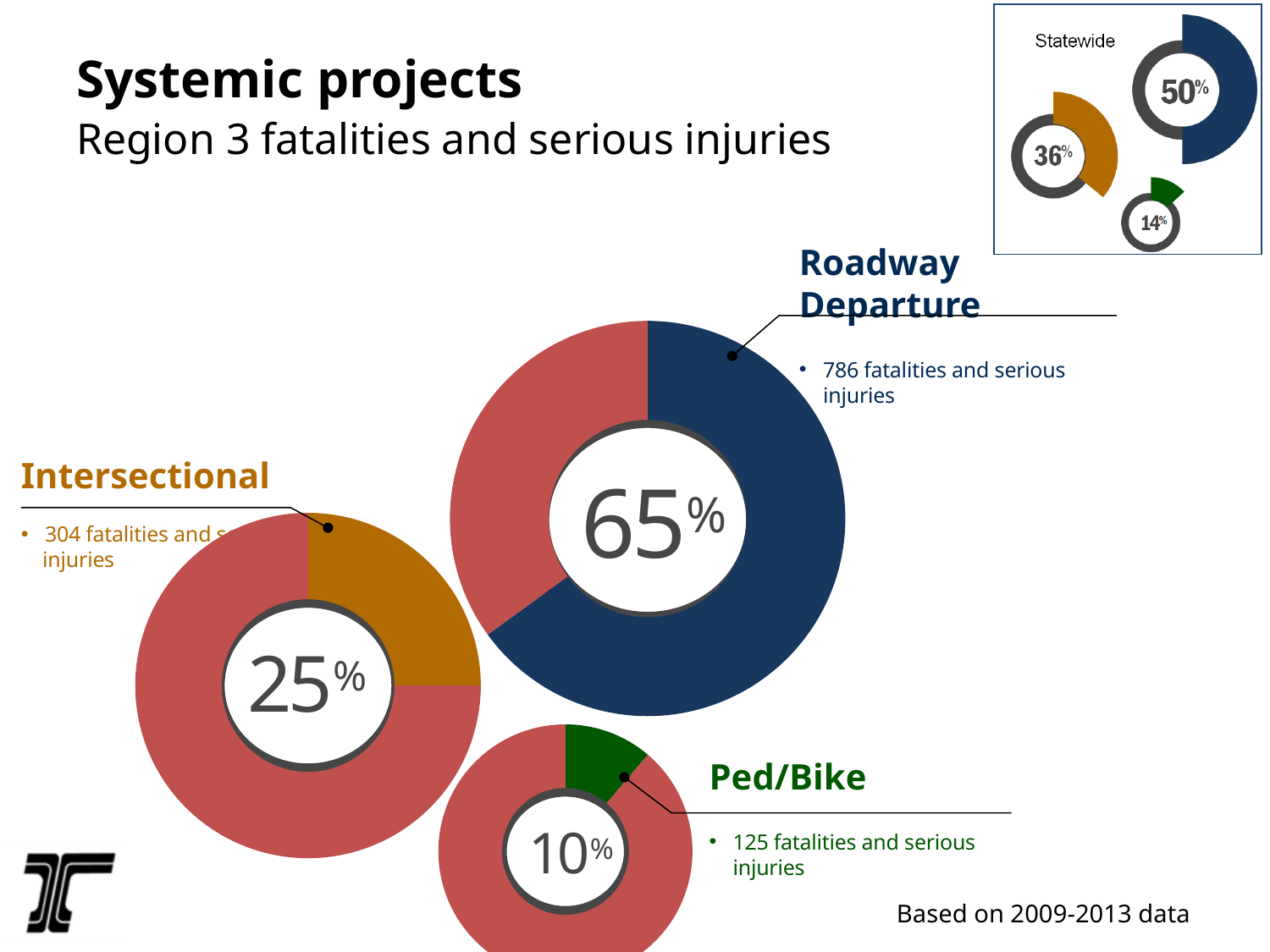
How many more fatalities and serious injuries does Roadway Departure have than Ped/Bike? 661 How many fatalities and serious injuries are listed for Roadway Departure? 786 Which category accounts for the largest share of Region 3 fatalities and serious injuries? Roadway Departure How many fatalities and serious injuries are listed for Intersectional? 304 How many crash categories are shown in the main Region 3 charts? 3 What years of data are the charts based on? 2009-2013 In the Statewide inset chart, what is the largest percentage shown? 50% What percentage of Region 3 fatalities and serious injuries is attributed to Ped/Bike? 10% What percentage of Region 3 fatalities and serious injuries is attributed to Roadway Departure? 65% Which category accounts for the smallest share of Region 3 fatalities and serious injuries? Ped/Bike What percentage of Region 3 fatalities and serious injuries is attributed to Intersectional crashes? 25% How many fatalities and serious injuries are listed for Ped/Bike? 125